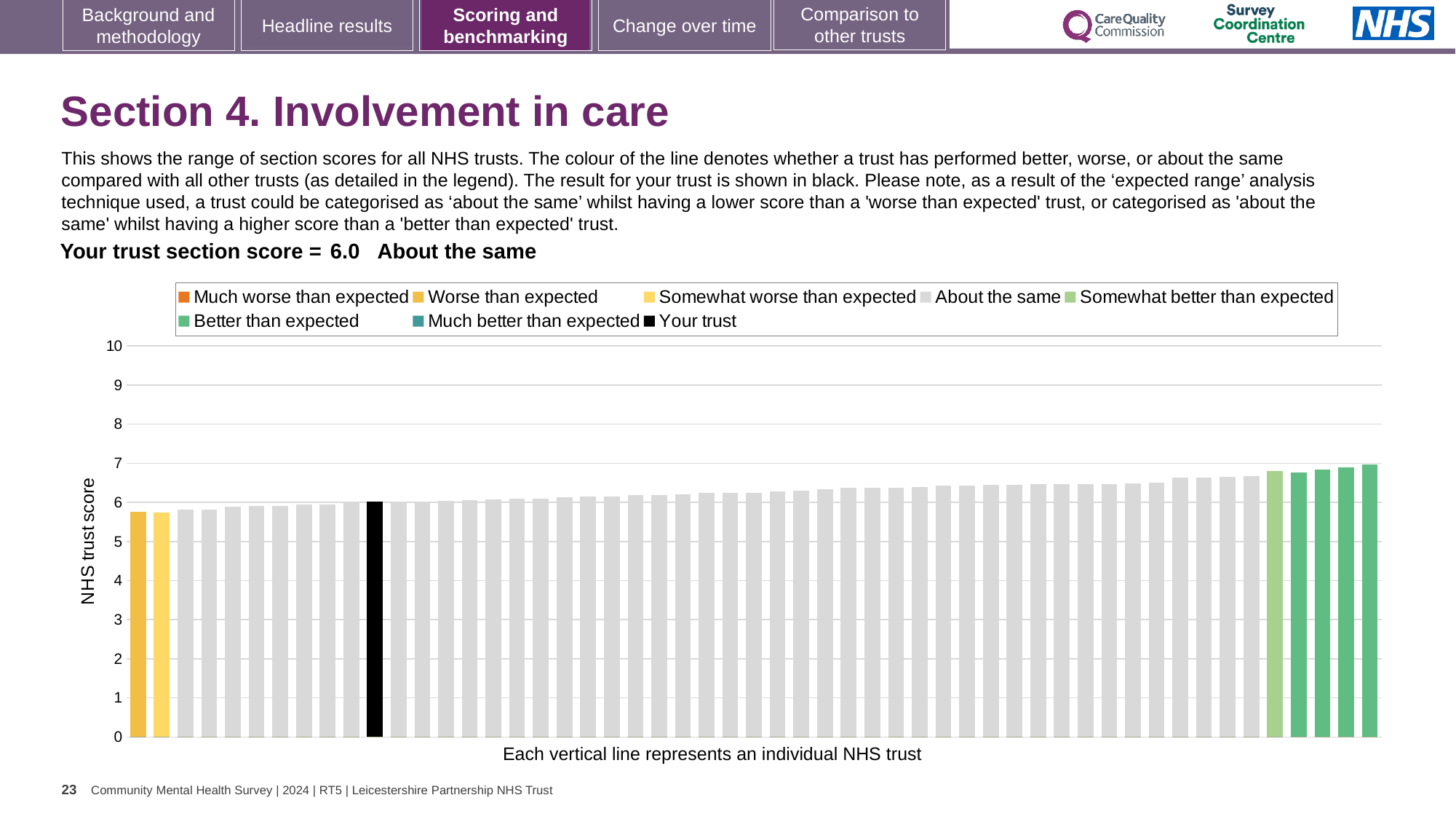
How many entries does the chart legend list? 8 What is the label on the vertical axis of the chart? NHS trust score What is the trust's section score for Involvement in care? 6.0 Which performance category is the trust's section score placed in? About the same Do the bar values rise or fall from left to right across the chart? rise Which is higher: the rightmost bar or the black bar for your trust? the rightmost bar What colour is the bar representing your trust? black Is the value of the rightmost bar greater or less than 6? greater Which is higher: the black bar for your trust or the leftmost bar? the black bar for your trust What kind of chart is shown on the slide? bar chart Is the value of the leftmost bar greater or less than 6? less